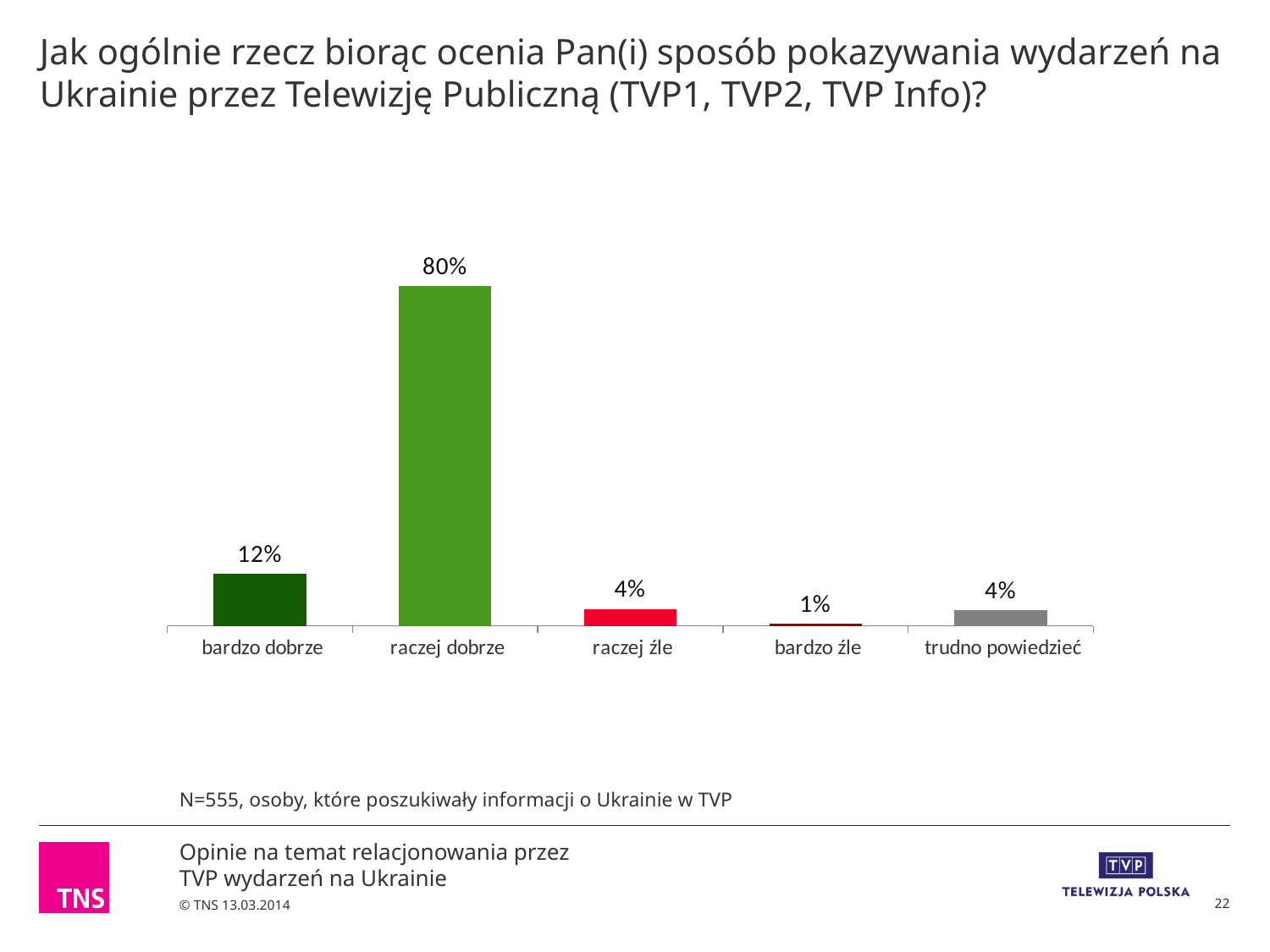
Which is larger, the value for "bardzo dobrze" or the value for "raczej źle"? bardzo dobrze What is the value for "raczej dobrze"? 80% How many categories are shown on the x axis? 5 Which category has the lowest value? bardzo źle What is the value for "trudno powiedzieć"? 4% Which category has the highest value? raczej dobrze What is the difference between the values for "raczej źle" and "bardzo źle"? 3% What kind of chart is shown on the slide? bar chart What is the sample size (N) stated below the chart? N=555 What is the value for "bardzo źle"? 1% What is the difference between the values for "raczej dobrze" and "bardzo dobrze"? 68% What is the value for "bardzo dobrze"? 12%